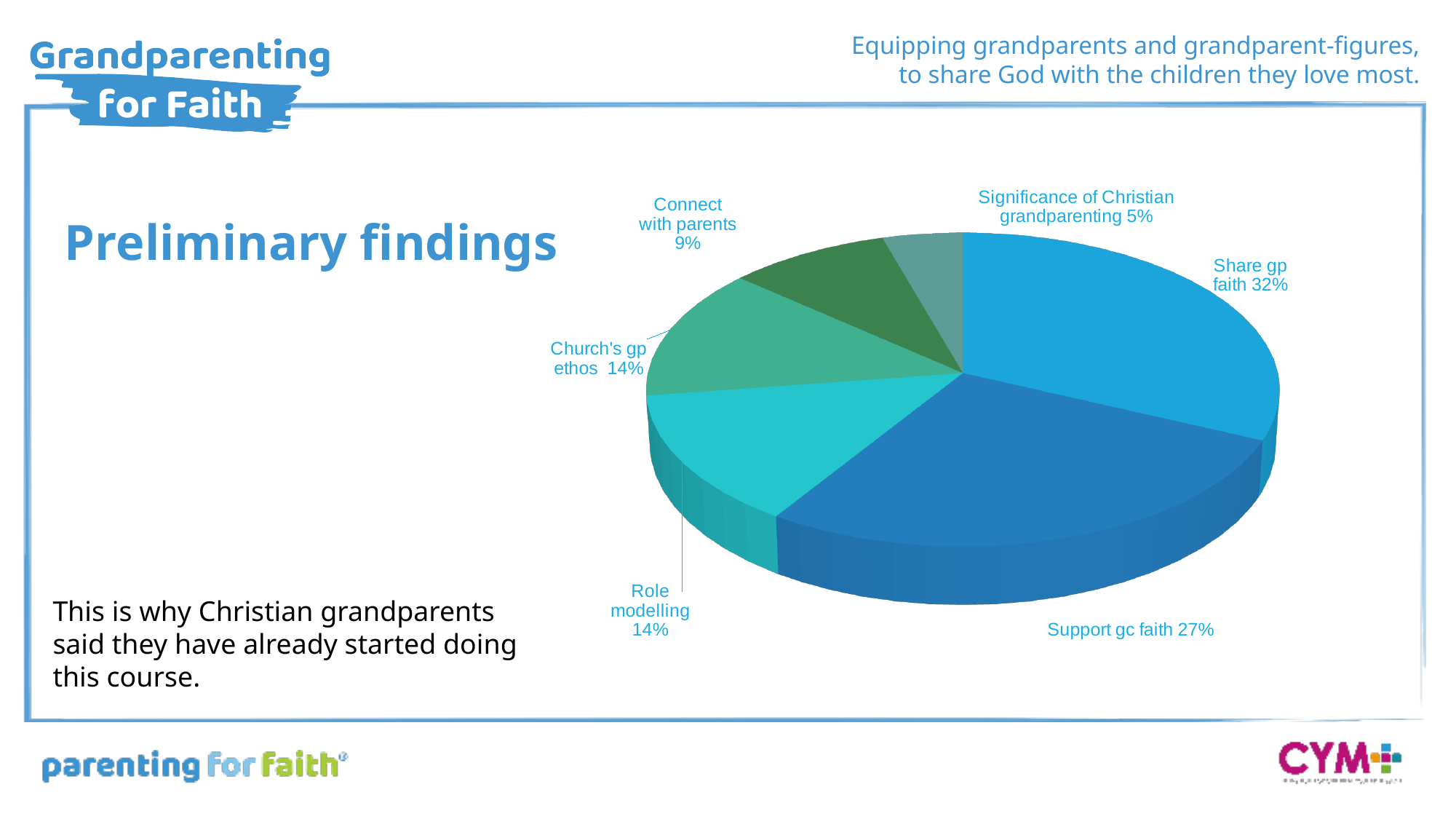
Which is larger, Connect with parents or Church's gp ethos? Church's gp ethos Which category has the smallest share of the pie? Significance of Christian grandparenting What percentage is shown for Significance of Christian grandparenting? 5% How many categories are shown in the pie chart? 6 What is the title of the slide containing the pie chart? Preliminary findings What percentage is shown for Share gp faith? 32% What is the difference in percentage points between Share gp faith and Support gc faith? 5 What percentage is shown for Connect with parents? 9% What percentage is shown for Support gc faith? 27% Which category has the largest share of the pie? Share gp faith What percentage is shown for Role modelling? 14% What kind of chart is shown on the slide? Pie chart